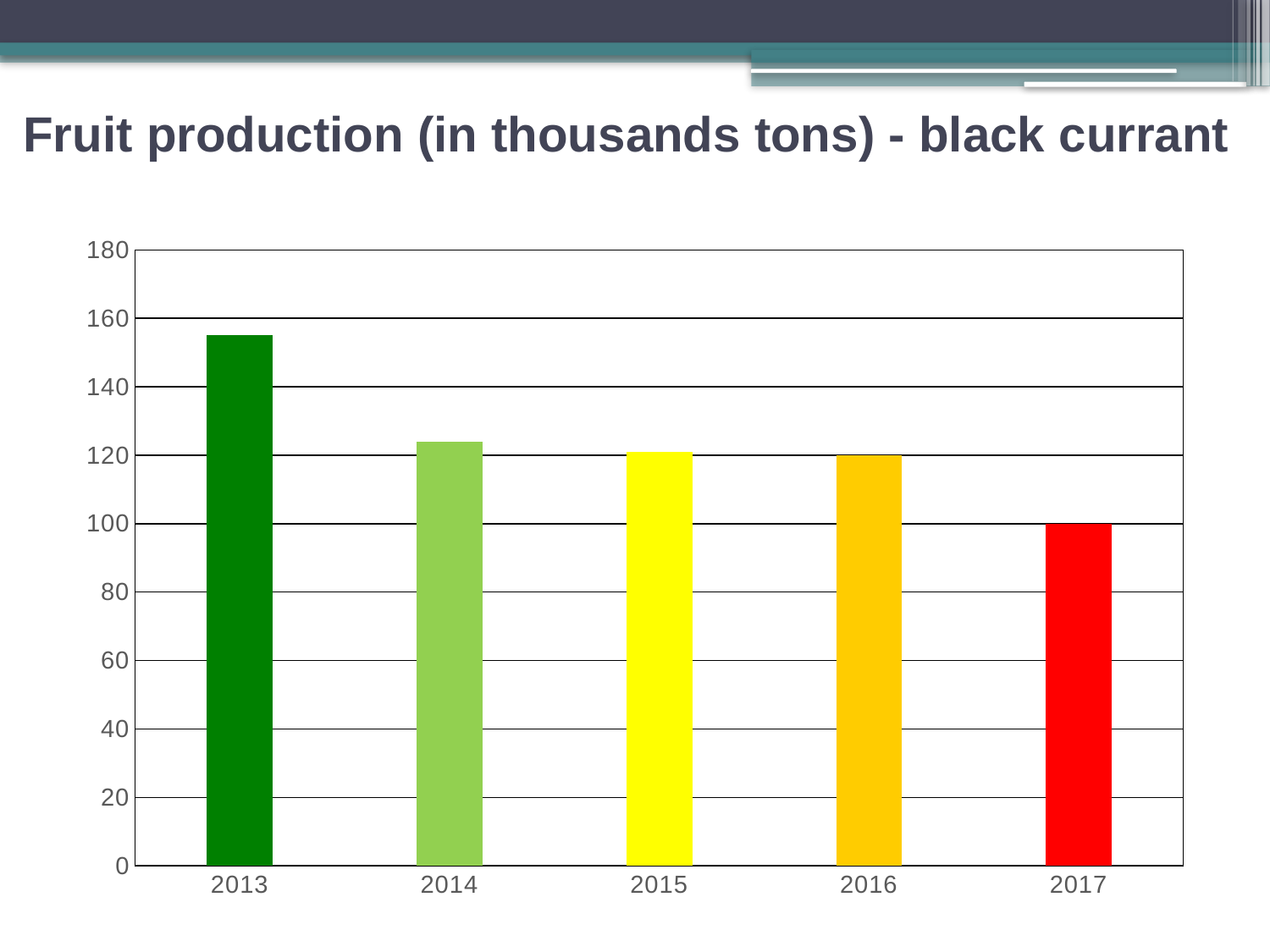
What is the title of the chart on the slide? Fruit production (in thousands tons) - black currant Which year has the larger value, 2013 or 2014? 2013 Which year has the lowest black currant production? 2017 Is the value for 2015 greater or less than 100? greater What kind of chart is shown on the slide? bar chart What is the black currant production value for 2017? 100 Is the value for 2016 greater or less than 140? less Is the value for 2014 greater or less than 120? greater Which year has the highest black currant production? 2013 Do the values rise or fall from 2013 to 2017? fall How many years are shown on the x axis of the chart? 5